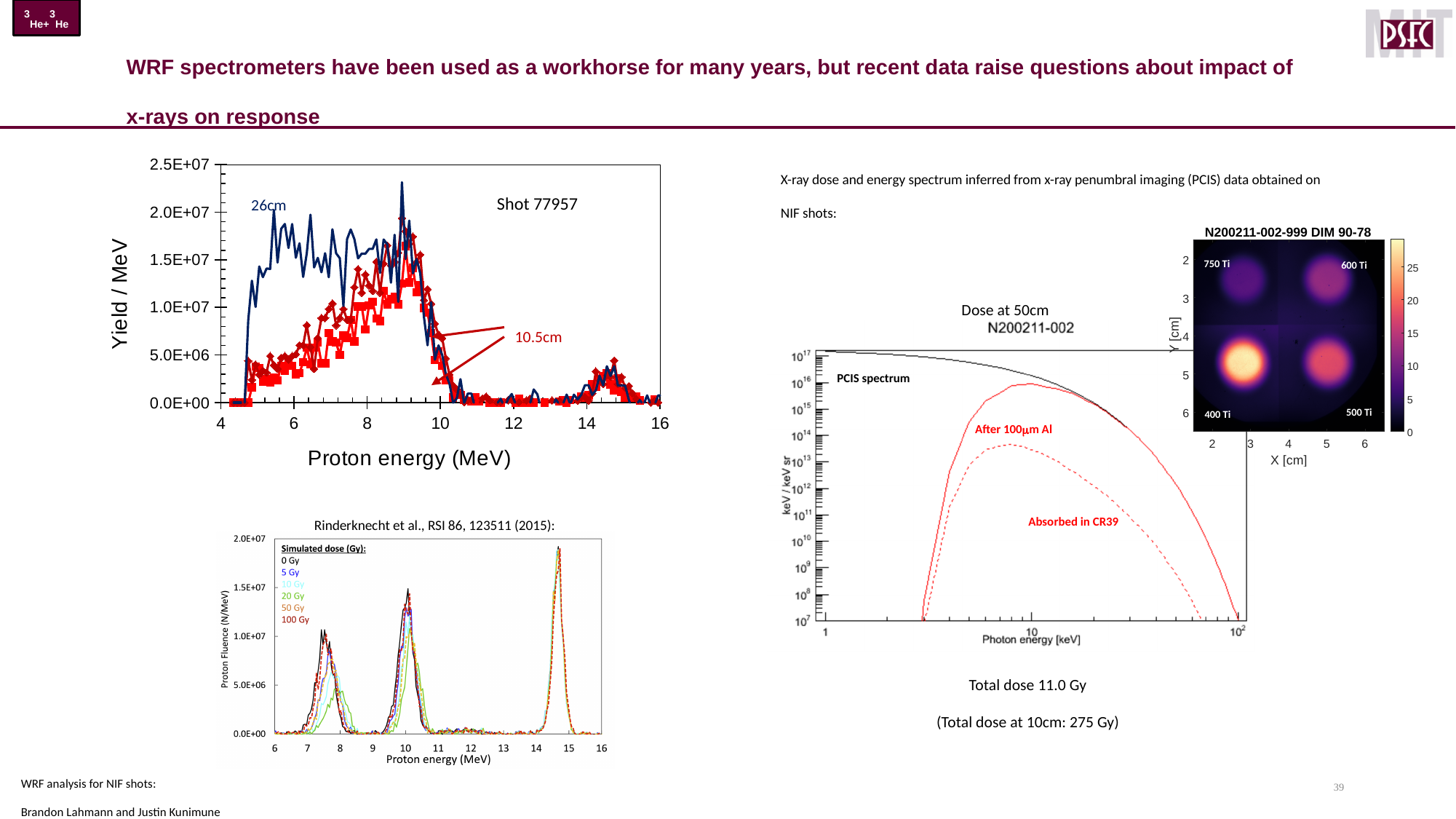
In the top-left chart (Shot 77957), is the peak value of the 26cm series near 9 MeV greater or less than 2.0E+07? greater In the bottom-left chart (Rinderknecht et al.), how many simulated dose values does the legend list? 6 In the top-left chart (Shot 77957), what is the label on the x axis? Proton energy (MeV) In the top-left chart (Shot 77957), what kind of chart is shown? line chart In the bottom-left chart (Rinderknecht et al.), what is the largest simulated dose listed in the legend? 100 Gy In the top-left chart (Shot 77957), is the value of the 10.5cm series at 6 MeV greater or less than 1.0E+07? less In the top-left chart (Shot 77957), what are the two distance labels given for the plotted series? 26cm and 10.5cm In the bottom-left chart (Rinderknecht et al.), is the peak near 14.7 MeV greater or less than 1.5E+07? greater In the top-left chart (Shot 77957), what is the highest tick value shown on the y axis? 2.5E+07 In the right-hand PCIS spectrum chart (N200211-002), what is the label on the x axis? Photon energy [keV] According to the text below the PCIS spectrum chart, what is the total dose at 10cm? 275 Gy